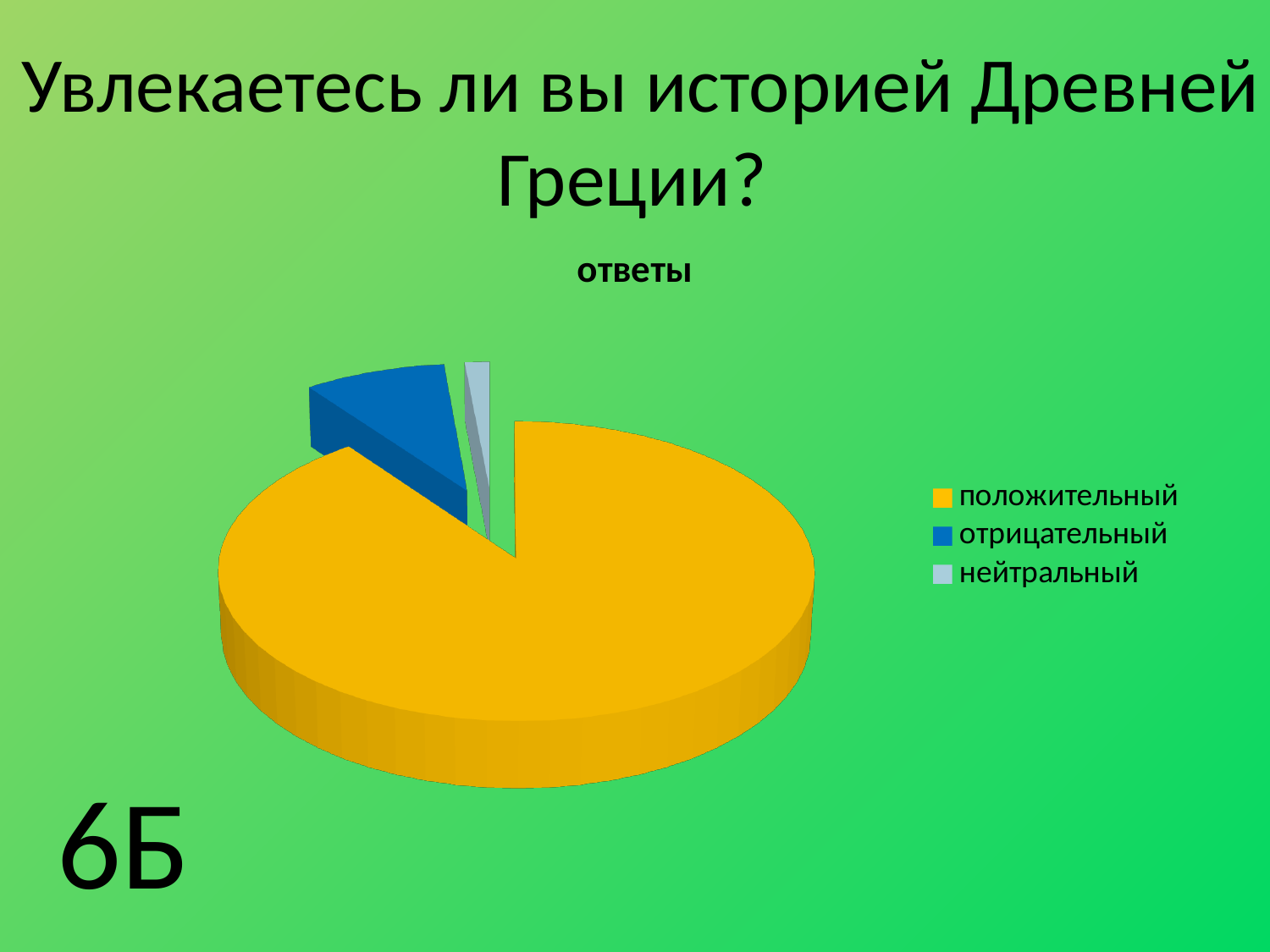
What colour is the slice for отрицательный? blue What kind of chart is shown on the slide? pie chart Which slice is larger, отрицательный or нейтральный? отрицательный Which category has the largest slice of the pie? положительный What is the title of the chart? ответы How many categories does the pie chart have? 3 How many entries does the legend list? 3 Which slice is larger, положительный or отрицательный? положительный Which category has the smallest slice of the pie? нейтральный